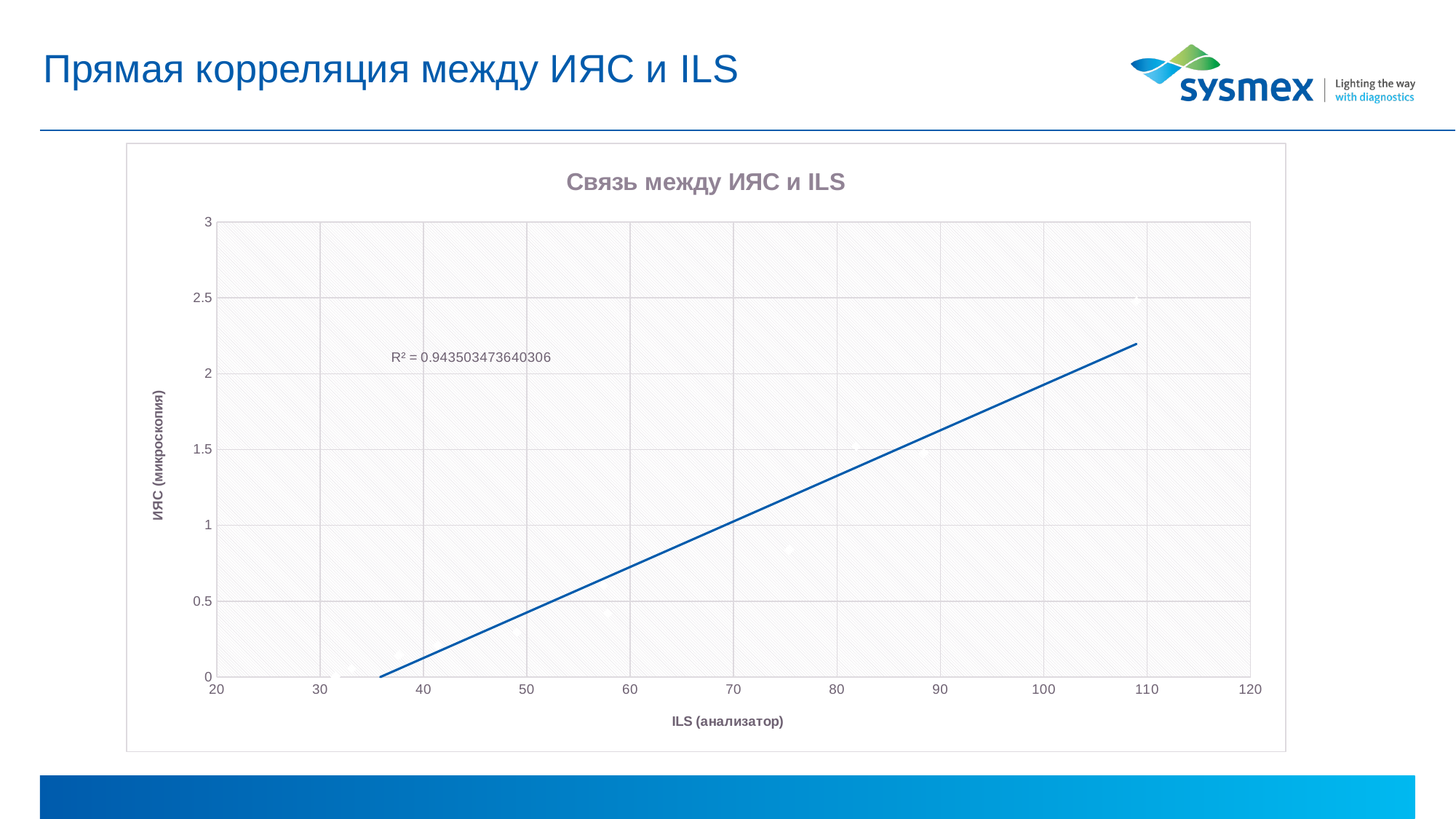
What is the label of the x axis? ILS (анализатор) At ILS = 110, is the trendline value greater or less than 2? greater What is the highest value shown on the x axis? 120 What is the title of the chart? Связь между ИЯС и ILS Does the trendline rise or fall as ILS increases along the x axis? Rises What R² value is printed on the chart? R² = 0.943503473640306 Is the R² value printed on the chart greater or less than 0.9? greater What kind of chart is shown on the slide? Scatter chart What is the lowest value shown on the x axis? 20 What is the highest value shown on the y axis? 3 At ILS = 60, is the trendline value greater or less than 1? less